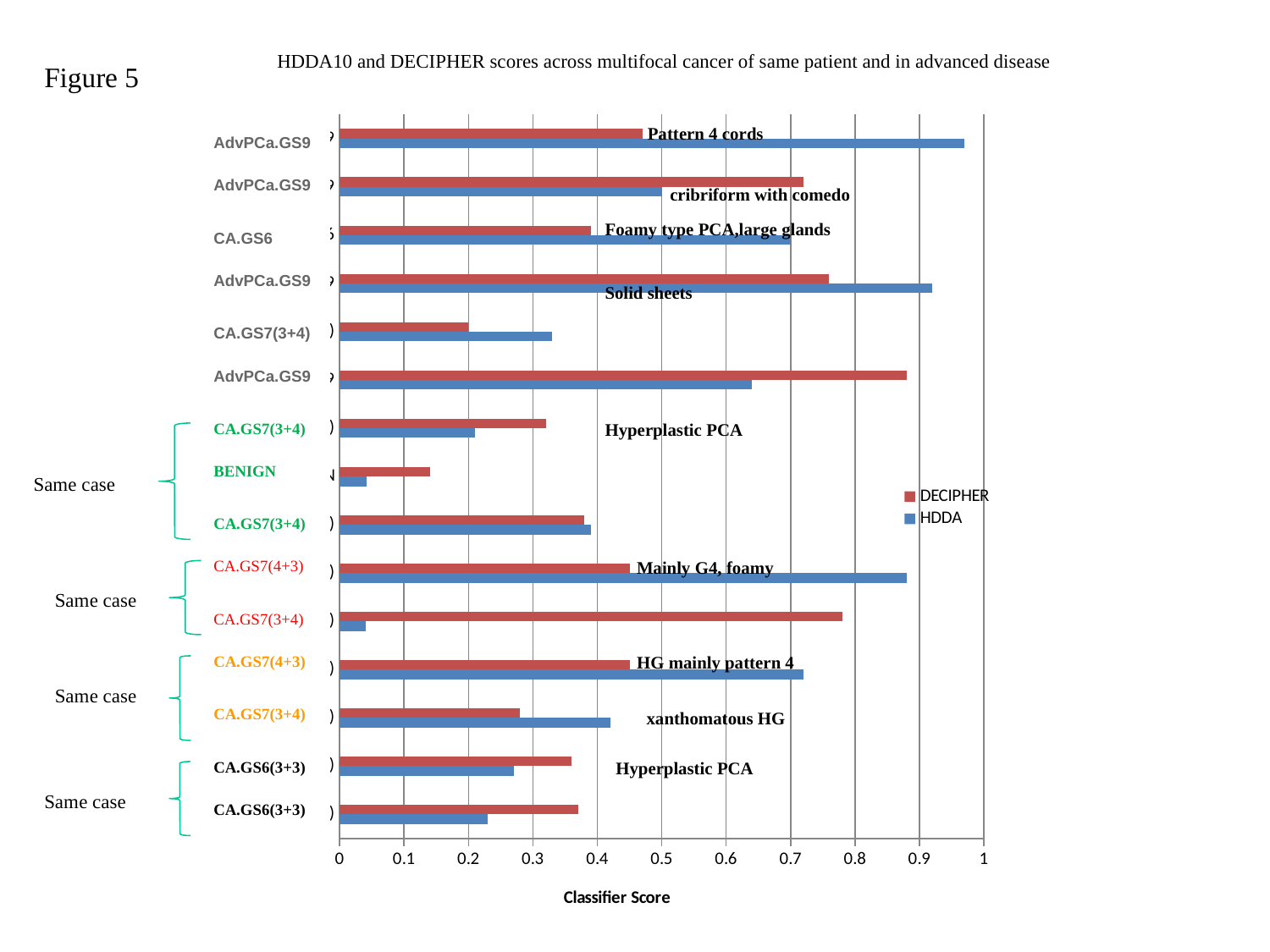
Is the DECIPHER value for CA.GS6 greater or less than 0.5? less Which category has the lowest DECIPHER value? BENIGN What kind of chart is shown on the slide? Bar chart What are the two series named in the legend? DECIPHER and HDDA Is the HDDA value for BENIGN greater or less than 0.1? less For CA.GS6, which series has the larger value, DECIPHER or HDDA? HDDA Is the DECIPHER value for BENIGN greater or less than 0.1? greater What is the title of the x axis? Classifier Score How many category rows are plotted in the chart? 15 For BENIGN, which series has the larger value, DECIPHER or HDDA? DECIPHER How many series does the legend list? 2